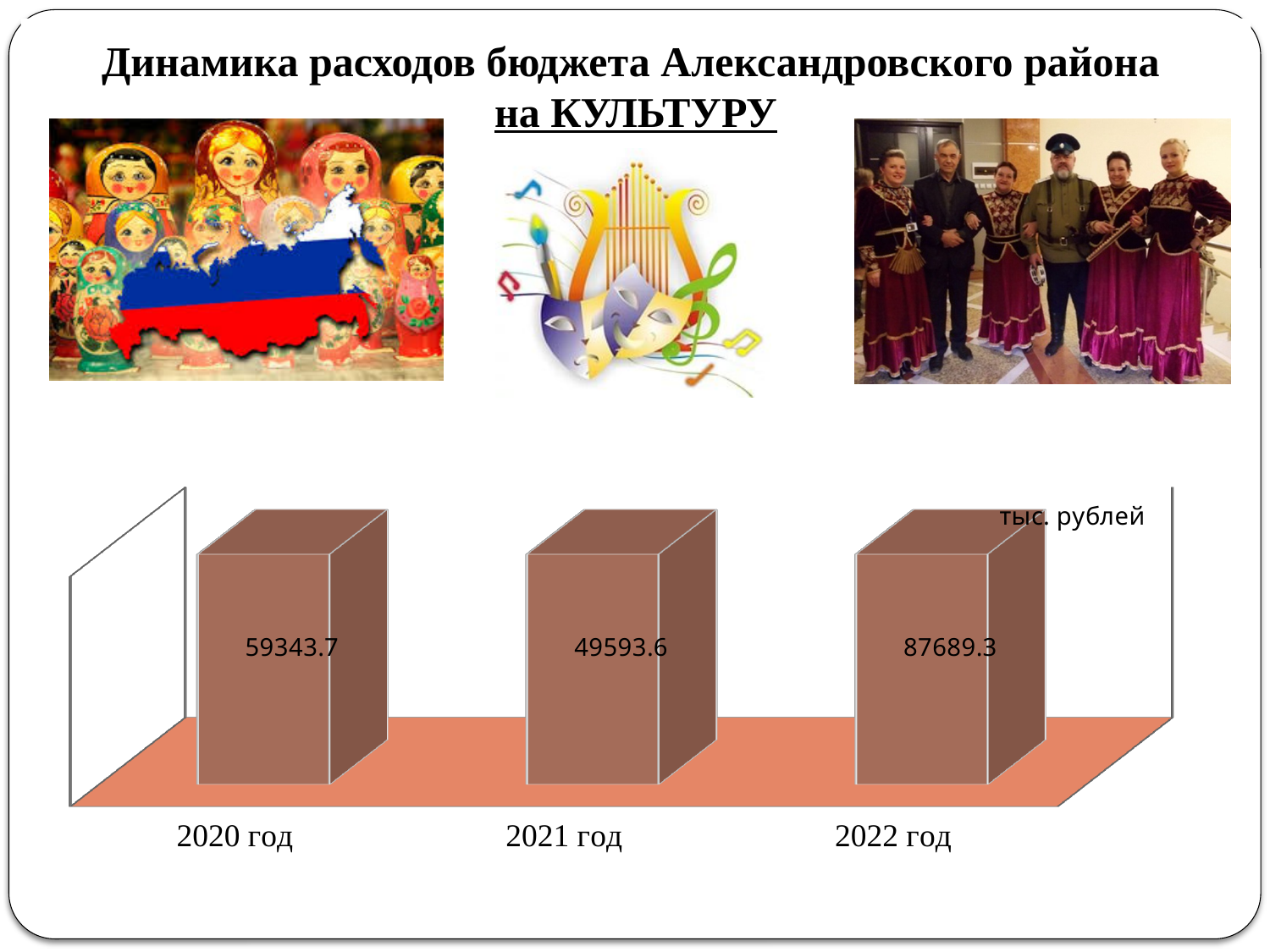
In what units are the chart values given? тыс. рублей What is the budget expenditure on culture for 2021 год? 49593.6 Which year has the lowest expenditure on culture? 2021 год Which is larger, the value for 2020 год or the value for 2021 год? 2020 год Which year has the highest expenditure on culture? 2022 год What is the difference between the 2022 год and 2020 год values? 28345.6 How many years are shown in the chart? 3 What is the difference between the 2020 год and 2021 год values? 9750.1 What is the budget expenditure on culture for 2022 год? 87689.3 What is the budget expenditure on culture for 2020 год? 59343.7 What kind of chart is shown on the slide? bar chart Does the value rise or fall from 2021 год to 2022 год? rise